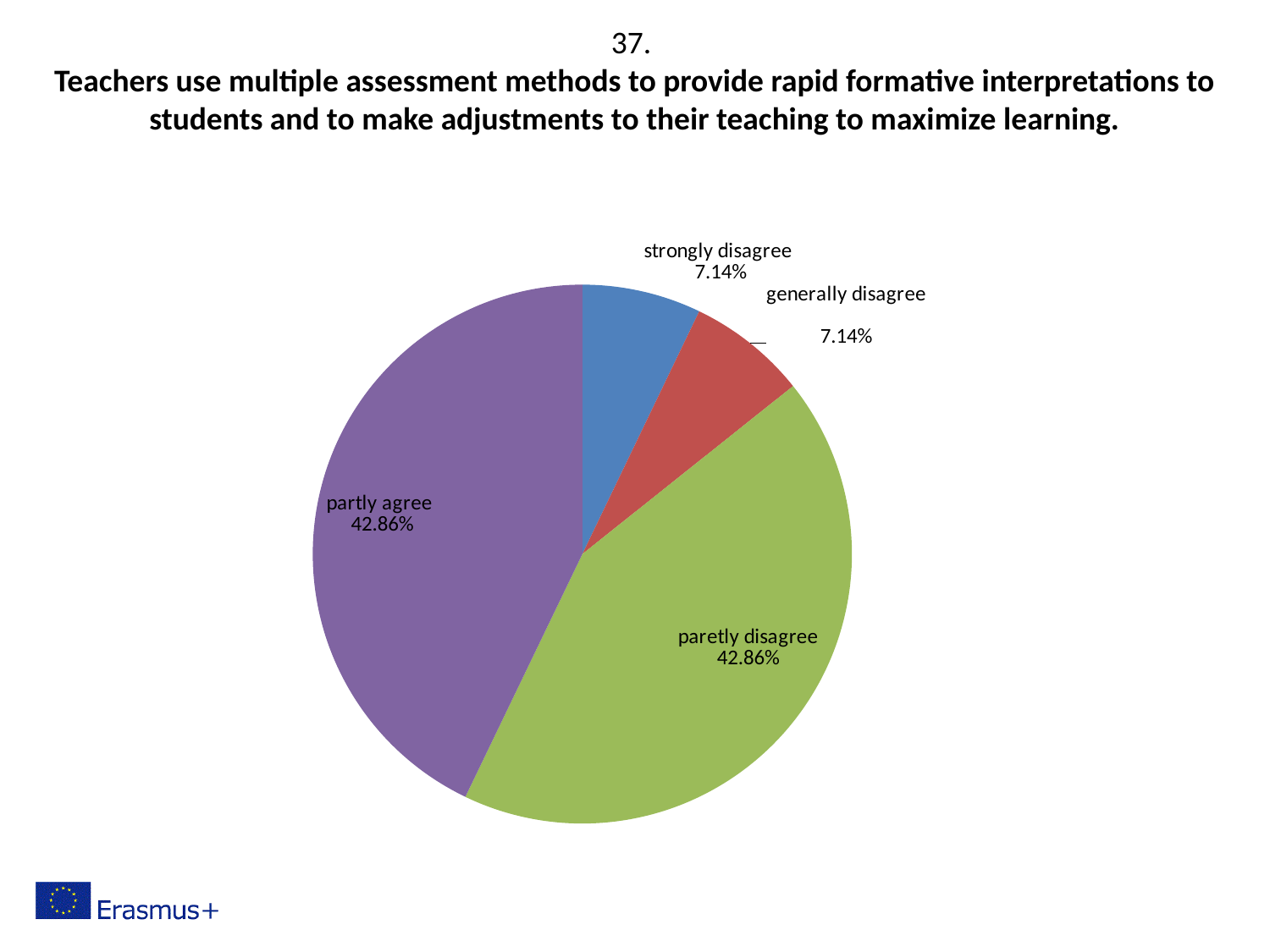
How many slices does the pie chart have? 4 What kind of chart is shown on the slide? pie chart What share of the pie is labelled "generally disagree"? 7.14% What is the difference between the "partly agree" share and the "strongly disagree" share? 35.72% What share of the pie is labelled "partly agree"? 42.86% What share of the pie is labelled "paretly disagree"? 42.86% What number appears above the slide title? 37. Which is larger, the "paretly disagree" slice or the "generally disagree" slice? paretly disagree What is the combined share of the "strongly disagree" and "generally disagree" slices? 14.28% What colour is the "partly agree" slice? purple Which is larger, the "partly agree" slice or the "strongly disagree" slice? partly agree